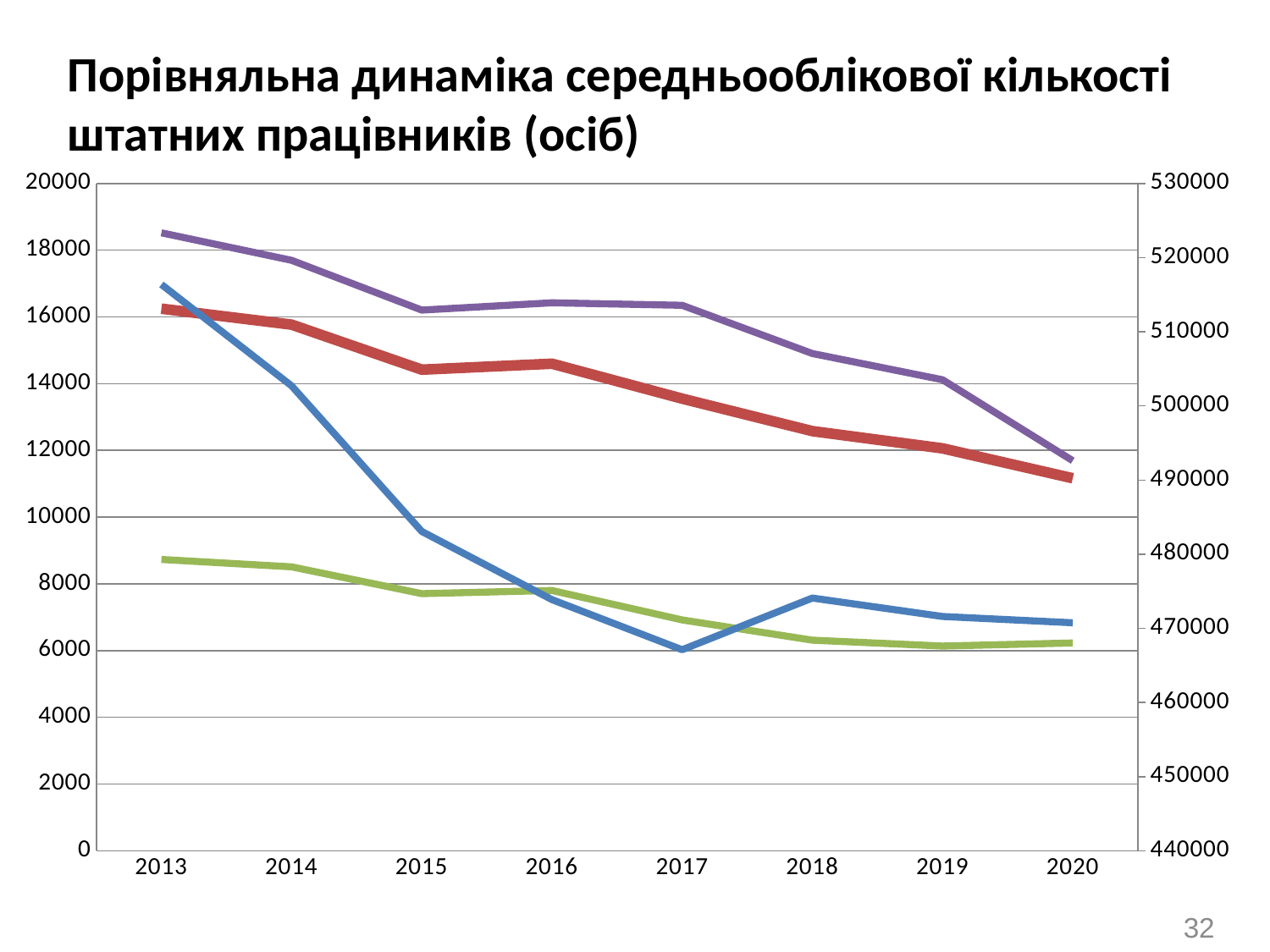
How many lines are plotted on the chart? 4 In 2013, which line is plotted higher on the chart, the blue line or the green line? blue line How many years are shown along the x axis of the chart? 8 In which year is the purple line at its lowest point? 2020 What kind of chart is shown on the slide? line chart What is the title of the chart? Порівняльна динаміка середньооблікової кількості штатних працівників (осіб) What is the first year shown on the x axis? 2013 In which year is the purple line at its highest point? 2013 In which year does the blue line reach its lowest point? 2017 Does the purple line generally rise or fall from 2013 to 2020? fall In which year is the red line at its lowest point? 2020 Does the blue line rise or fall between 2013 and 2017? fall